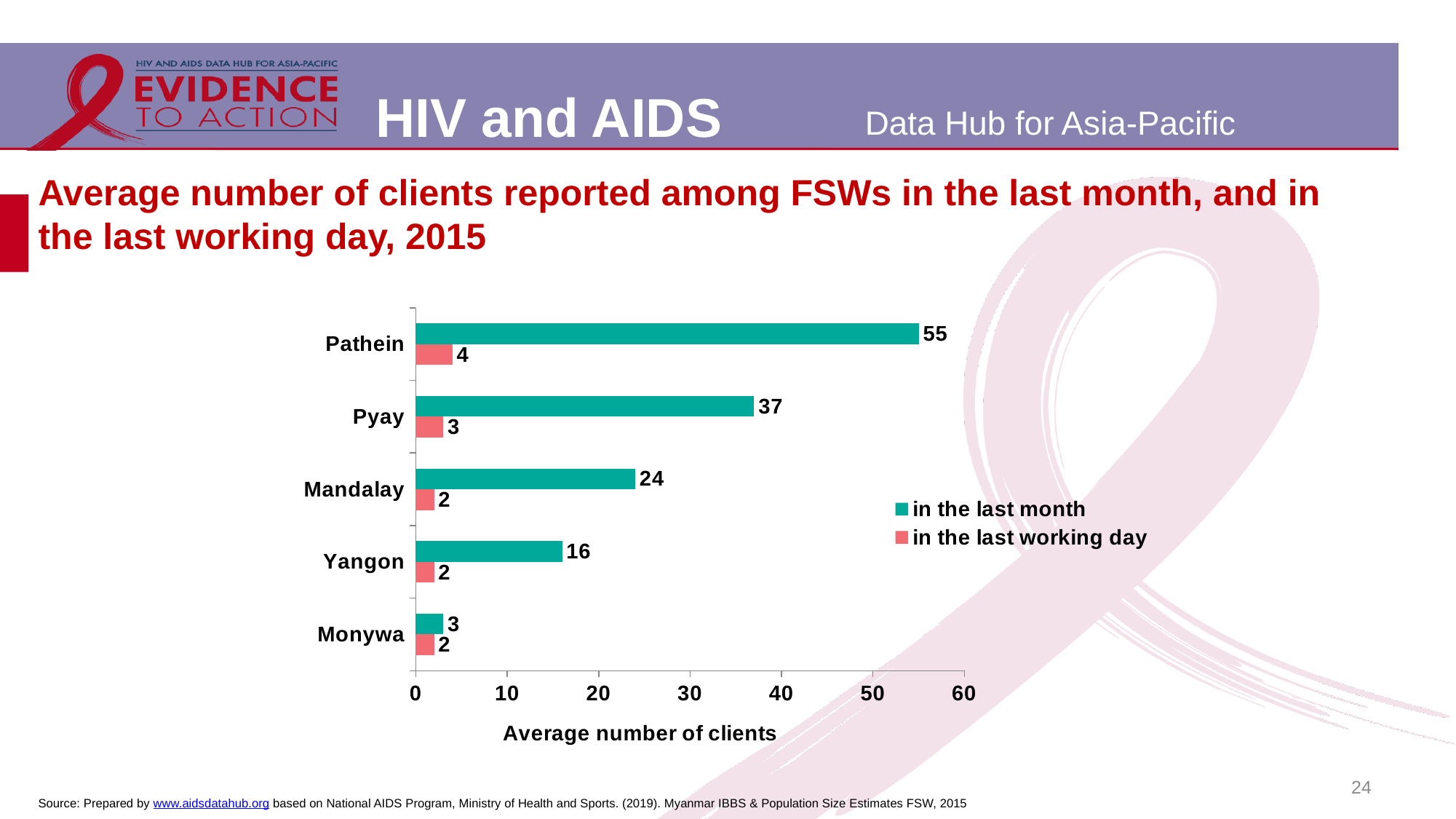
What is the difference between the last-month values for Pathein and Pyay? 18 What kind of chart is shown on the slide? Bar chart How many series does the legend list? 2 How many cities are shown on the chart? 5 What is the average number of clients in the last month for Mandalay? 24 Which city has the highest average number of clients in the last month? Pathein Which is larger: the last-month value for Yangon or for Mandalay? Mandalay What is the difference between the last-month and last-working-day values for Yangon? 14 What is the label of the x axis? Average number of clients Which city has the lowest average number of clients in the last month? Monywa What is the average number of clients in the last working day for Pyay? 3 What is the average number of clients in the last month for Pathein? 55